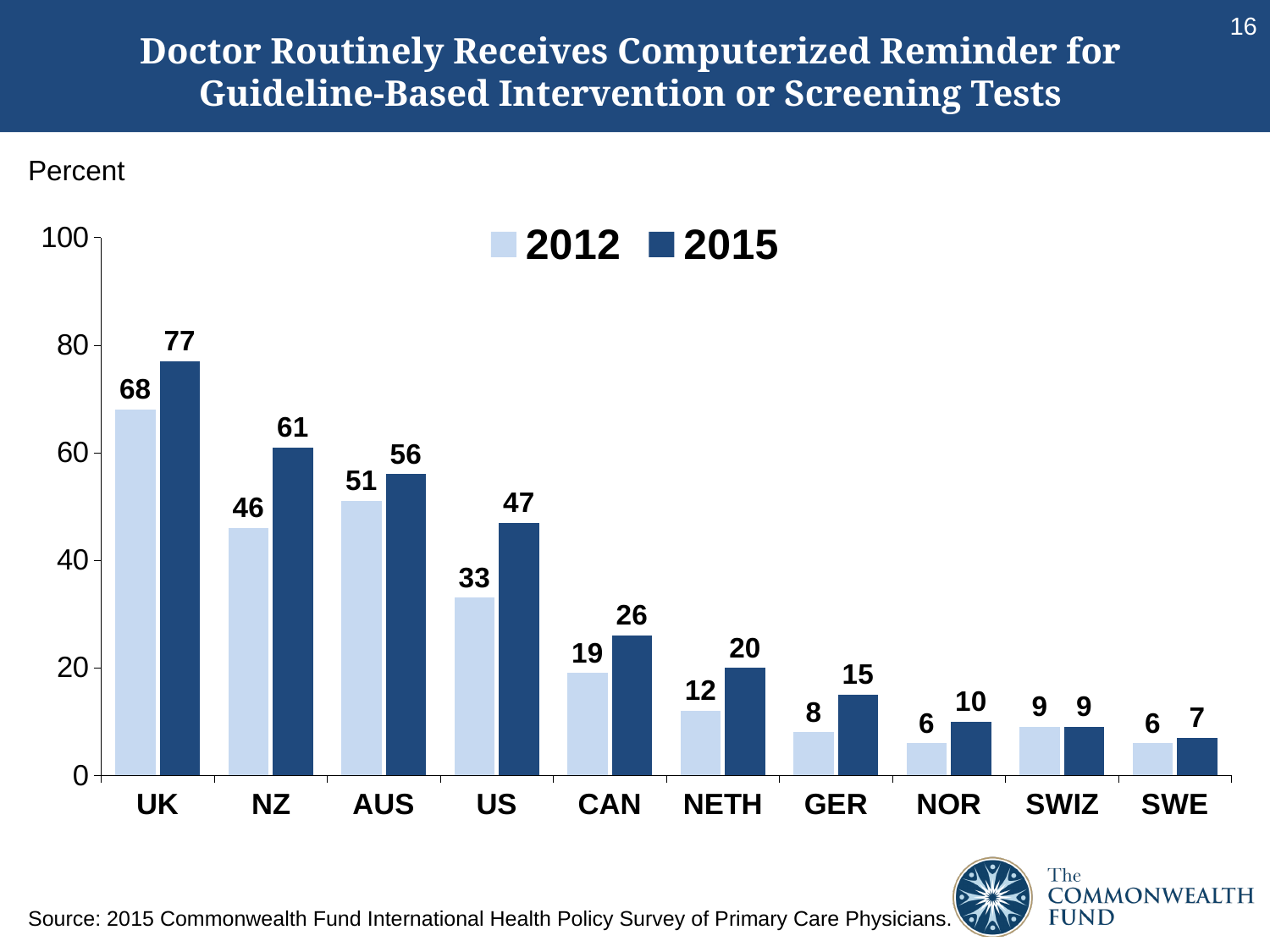
What is the 2012 value for CAN? 19 What are the two series listed in the legend? 2012 and 2015 Which country has the lowest 2012 value? NOR and SWE (both 6) What kind of chart is shown on the slide? bar chart What is the difference between the 2015 and 2012 values for the US? 14 How many countries are shown on the x axis? 10 Is the 2015 value for AUS greater or less than 40? greater Do the 2015 values generally rise or fall from left to right along the x axis? fall Which is larger for NZ, the 2012 value or the 2015 value? 2015 What is the 2015 value for the UK? 77 Which country has the highest 2015 value? UK How many series does the legend list? 2